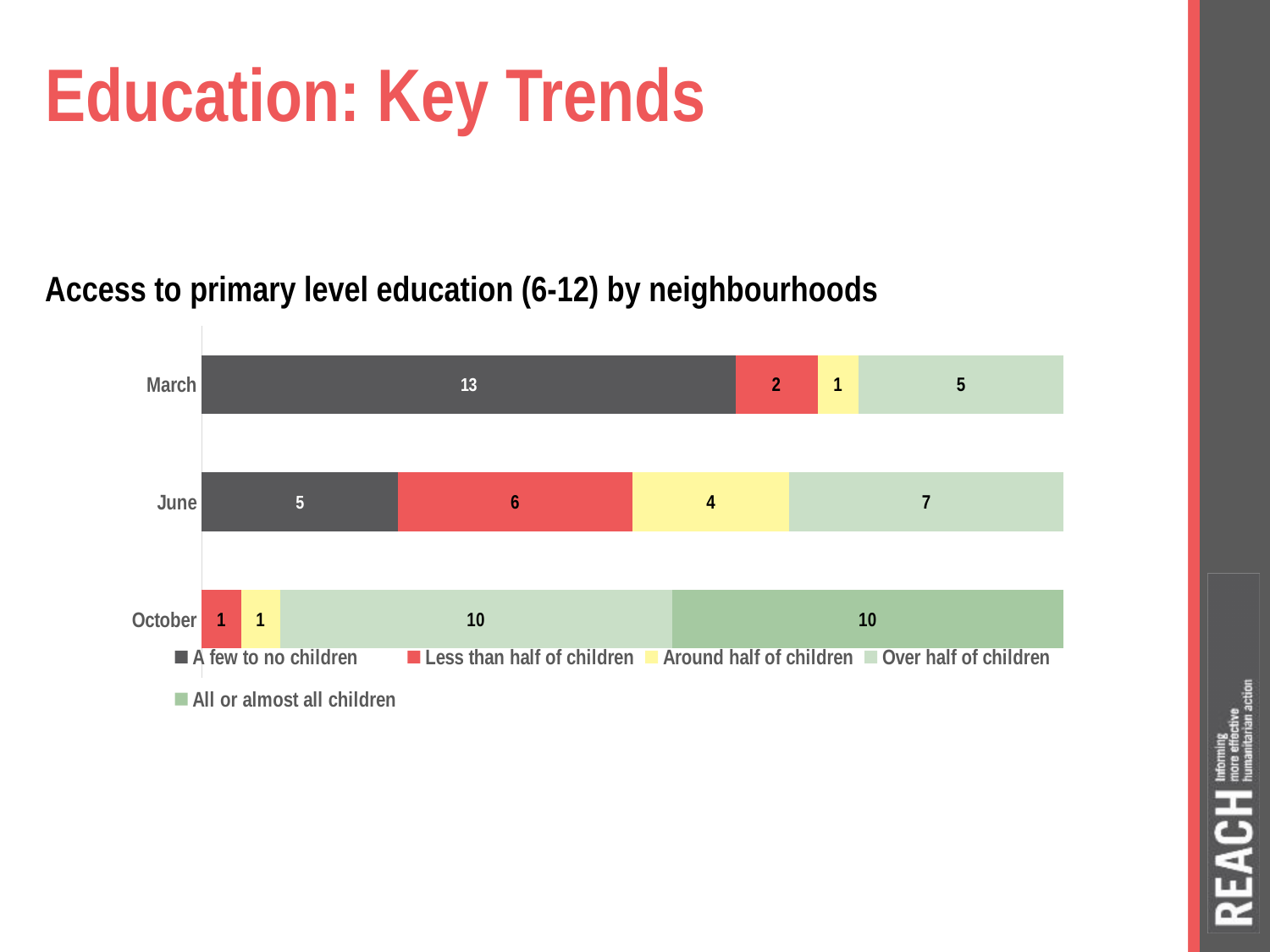
What is the difference between the 'A few to no children' values for March and June? 8 How many series does the legend list? 5 What is the title of the chart? Access to primary level education (6-12) by neighbourhoods What is the value for 'Less than half of children' in June? 6 In which month is the 'Over half of children' value lowest? March What kind of chart is shown on the slide? Stacked bar chart What is the value for 'A few to no children' in March? 13 What is the value for 'All or almost all children' in October? 10 How many months (categories) are shown on the chart? 3 Which is larger: the 'Around half of children' value in June or in March? June What is the total of the stacked bar for June? 22 In which month is the 'A few to no children' value highest? March